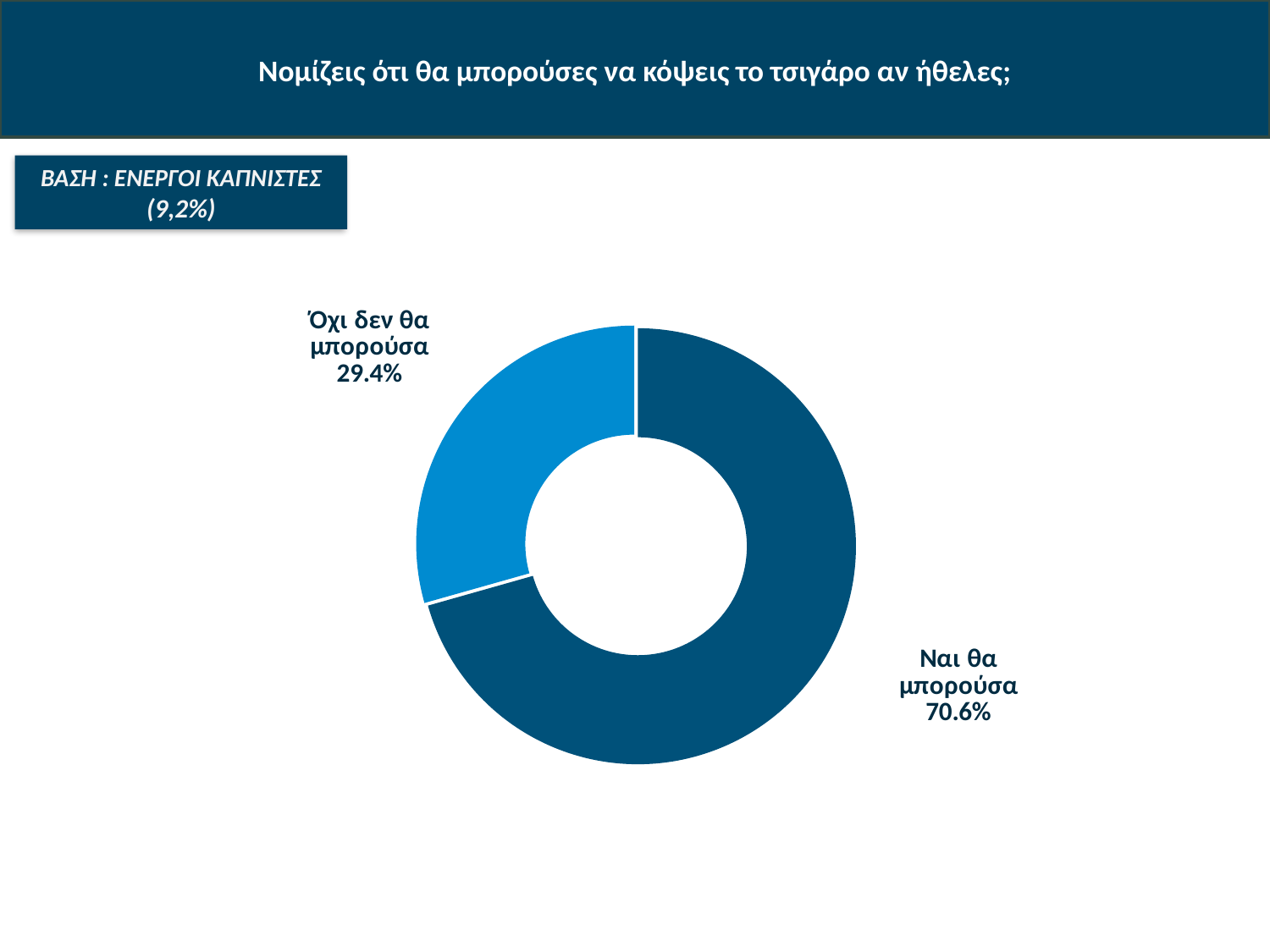
What share of the pie does the "Όχι δεν θα μπορούσα" slice represent? 29.4% Which response has the largest share of the pie? Ναι θα μπορούσα Which response has the smallest share of the pie? Όχι δεν θα μπορούσα How many categories are shown in the chart? 2 Which is larger: the share for "Ναι θα μπορούσα" or for "Όχι δεν θα μπορούσα"? Ναι θα μπορούσα What percentage of respondents answered "Ναι θα μπορούσα"? 70.6% What percentage of respondents answered "Όχι δεν θα μπορούσα"? 29.4% What kind of chart is shown on the slide? Pie chart (doughnut) What is the question shown as the title of the slide? Νομίζεις ότι θα μπορούσες να κόψεις το τσιγάρο αν ήθελες; What is the difference in percentage points between "Ναι θα μπορούσα" and "Όχι δεν θα μπορούσα"? 41.2 What base is stated for the chart in the box at the top left? ΕΝΕΡΓΟΙ ΚΑΠΝΙΣΤΕΣ (9,2%)